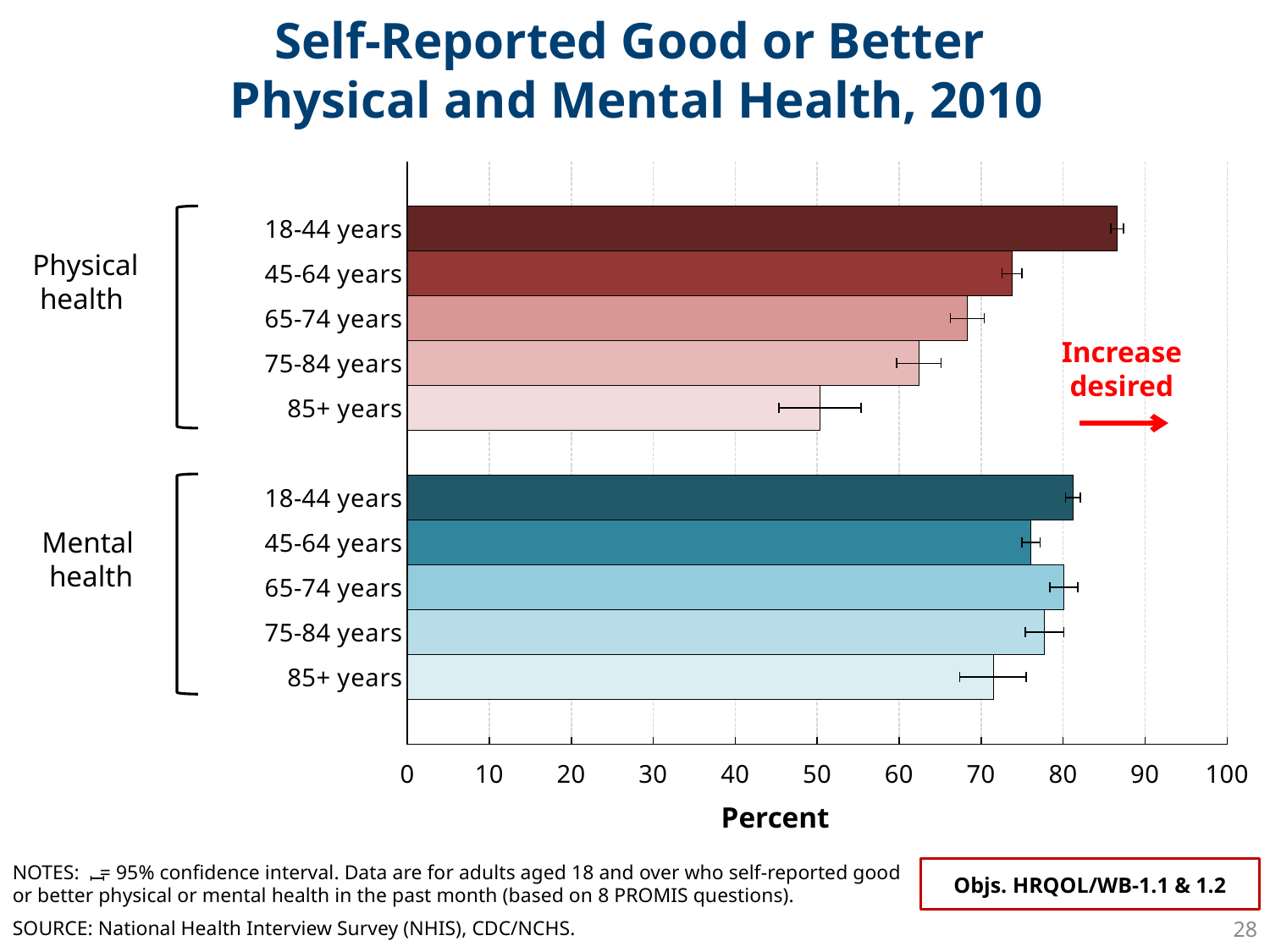
Do the Physical health values rise or fall as the age groups get older? fall Which is larger: the Physical health value for 18-44 years or the Mental health value for 18-44 years? Physical health 18-44 years What kind of chart is shown on the slide? bar chart Among the Mental health bars, which age group has the lowest value? 85+ years Among the Physical health bars, which age group has the lowest value? 85+ years Is the Physical health value for 85+ years greater or less than 60? less What is the label on the horizontal axis of the chart? Percent Is the Physical health value for 18-44 years greater or less than 80? greater Among the Physical health bars, which age group has the highest value? 18-44 years How many bars are plotted in total on the chart? 10 Is the Mental health value for 85+ years greater or less than 80? less How many age groups are shown for Physical health? 5